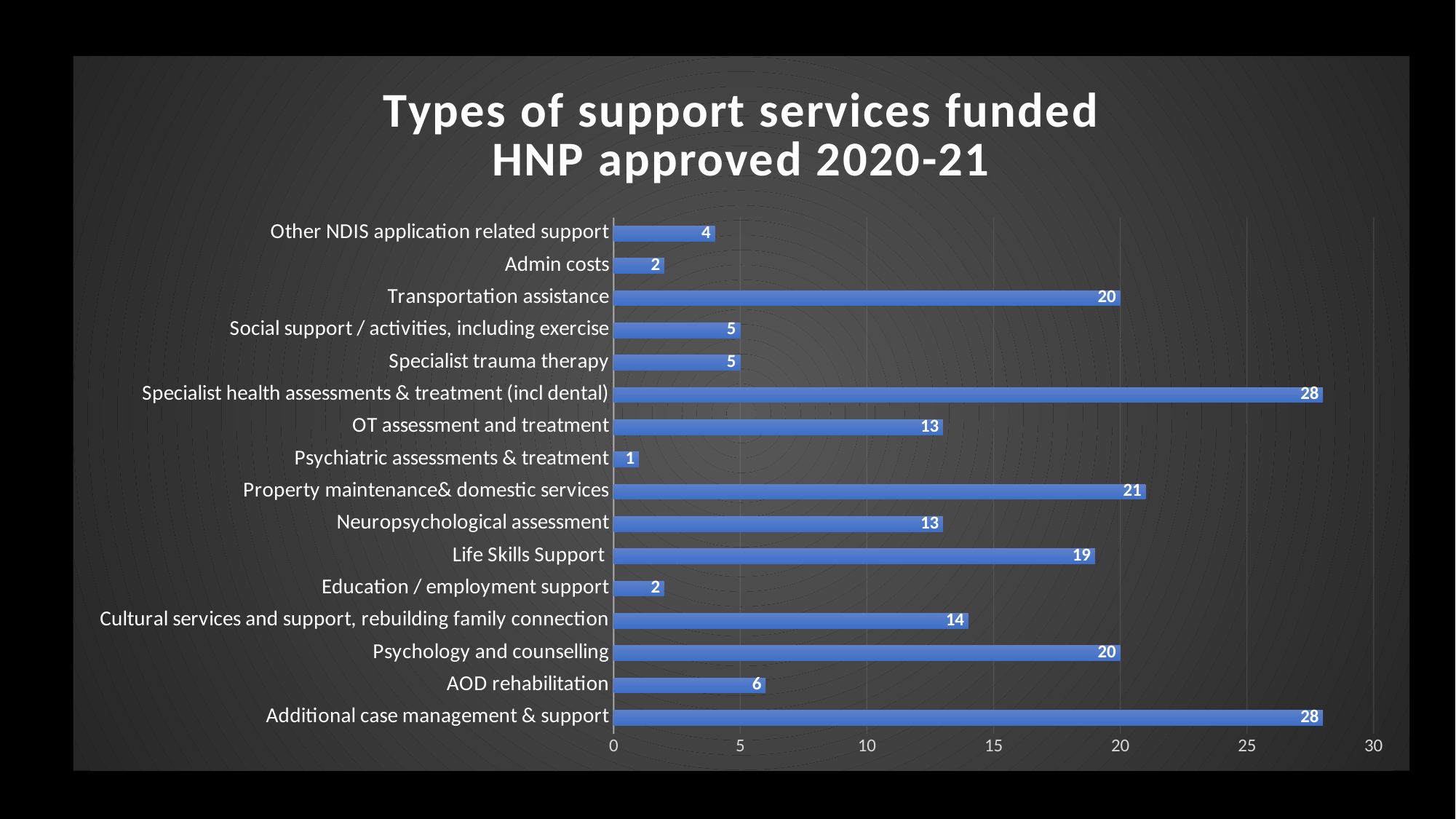
What is the difference between Property maintenance& domestic services and OT assessment and treatment? 8 Which category has the lowest value? Psychiatric assessments & treatment What is the difference between Additional case management & support and Psychology and counselling? 8 What is the title of the chart? Types of support services funded HNP approved 2020-21 What kind of chart is this? bar chart How many categories are shown in the chart? 16 What is the value for AOD rehabilitation? 6 What is the value for Transportation assistance? 20 What is the value for Cultural services and support, rebuilding family connection? 14 Which is larger, Life Skills Support or Neuropsychological assessment? Life Skills Support Is the value for Specialist health assessments & treatment (incl dental) greater or less than 25? greater What is the value for Life Skills Support? 19